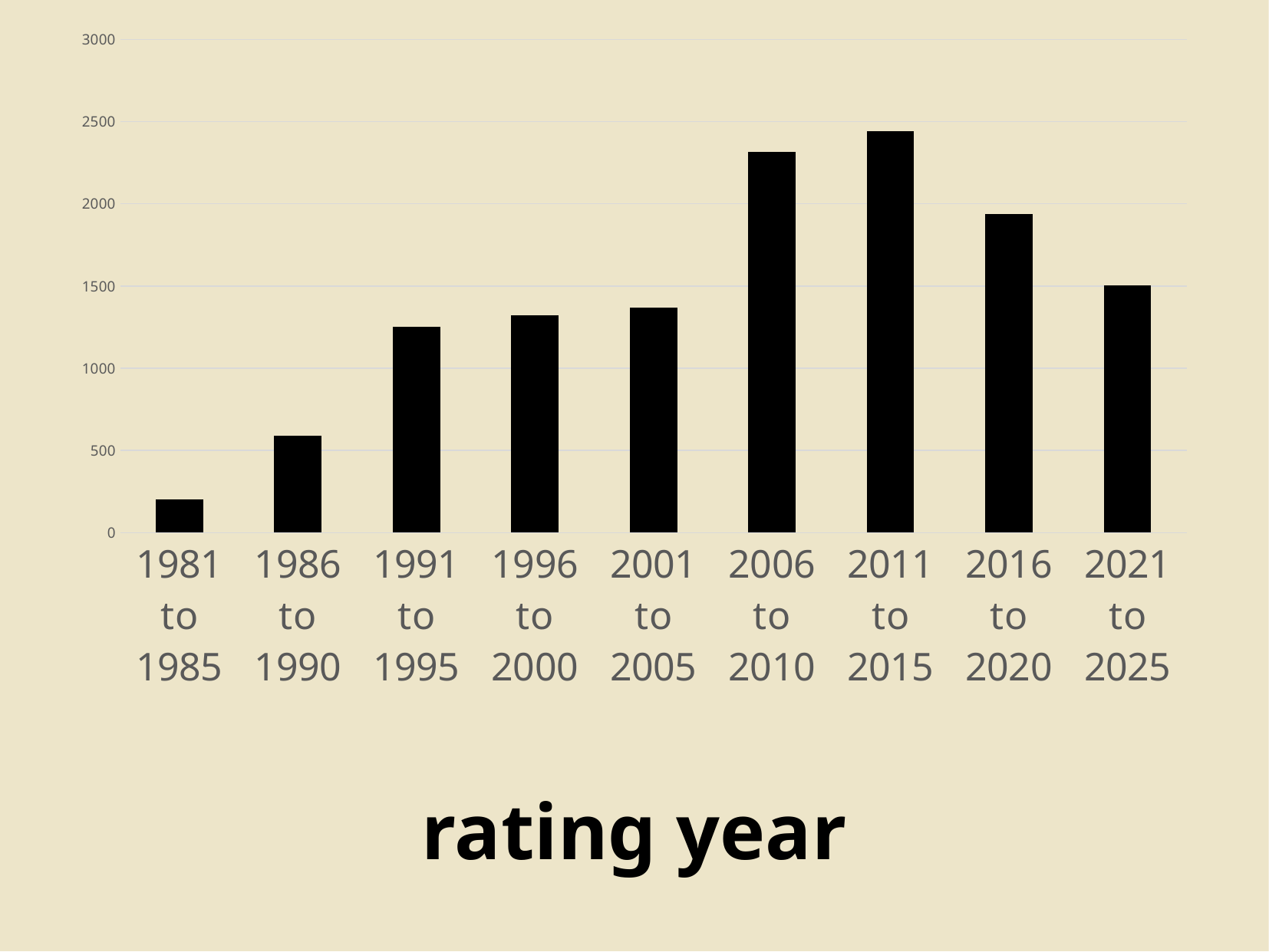
Which is larger, the value for 2006 to 2010 or the value for 2016 to 2020? 2006 to 2010 Which rating-year category has the lowest value? 1981 to 1985 What is the title of the x axis? rating year Is the value for 2001 to 2005 greater or less than 1500? less Is the value for 2006 to 2010 greater or less than 2000? greater Do the values rise or fall from 1981 to 1985 through 2011 to 2015? rise Which rating-year category has the highest value? 2011 to 2015 Is the value for 1986 to 1990 greater or less than 500? greater How many rating-year categories are shown on the x axis? 9 What kind of chart is shown on the slide? bar chart